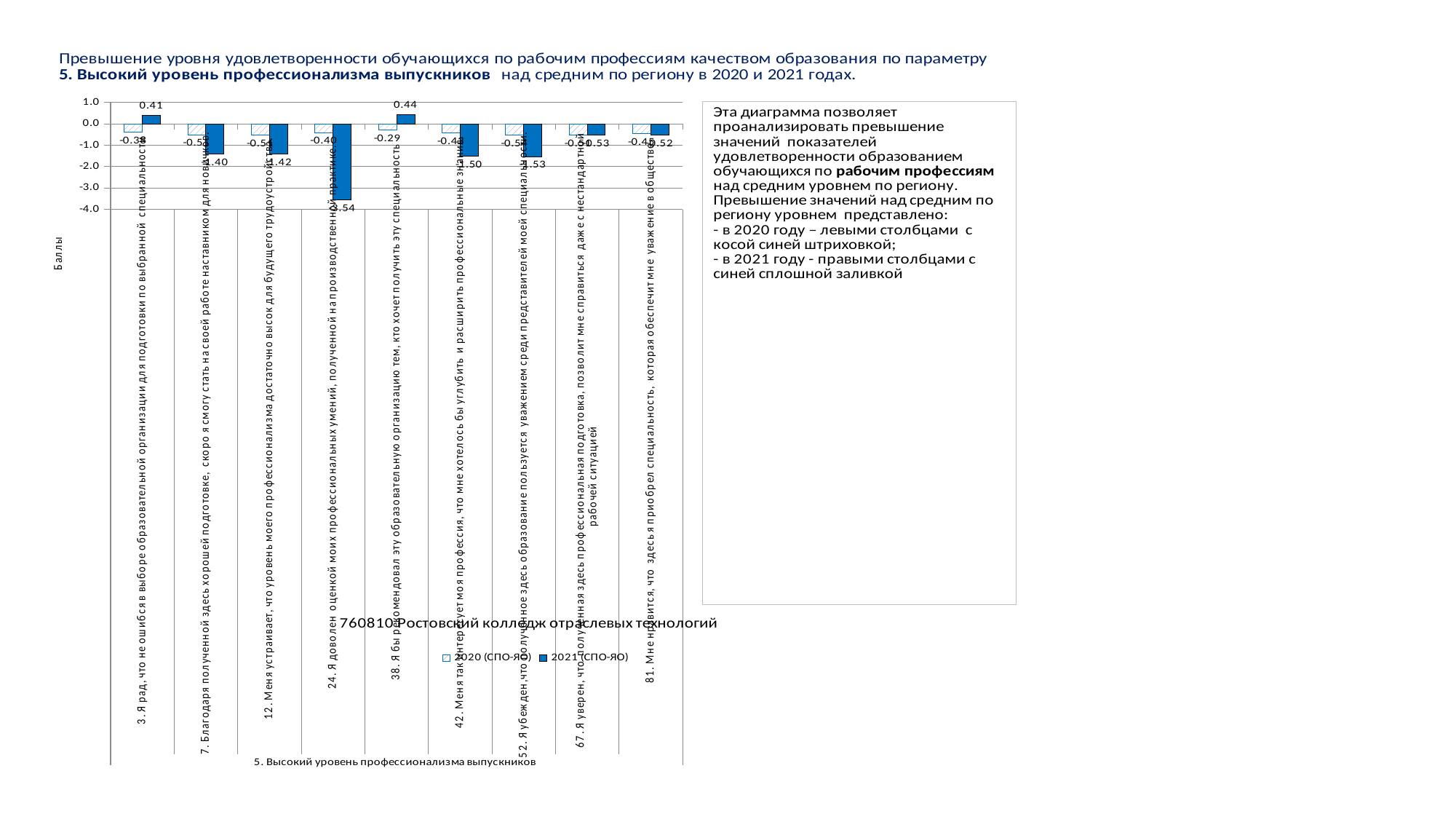
Is the 2021 (СПО-ЯО) value for statement 24 greater or less than -3.0? less How many statements (categories) are plotted on the x axis? 9 What kind of chart is shown on the slide? Bar chart Which statement has the highest 2021 (СПО-ЯО) value? 38. Я бы рекомендовал эту образовательную организацию тем, кто хочет получить эту специальность How many series does the legend list? 2 Which statement has the lowest 2021 (СПО-ЯО) value? 24. Я доволен оценкой моих профессиональных умений, полученной на производственной практике What is the 2021 (СПО-ЯО) value for the statement "3. Я рад, что не ошибся в выборе образовательной организации для подготовки по выбранной специальности"? 0.41 What is the 2020 (СПО-ЯО) value for the statement "81. Мне нравится, что здесь я приобрел специальность, которая обеспечит мне уважение в обществе"? -0.45 What is the 2021 (СПО-ЯО) value for the statement "24. Я доволен оценкой моих профессиональных умений, полученной на производственной практике"? -3.54 What is the difference between the 2021 (СПО-ЯО) values for statement 42 (-1.50) and statement 52 (-1.53)? 0.03 For statement 38, which is larger: the 2020 (СПО-ЯО) value or the 2021 (СПО-ЯО) value? 2021 (СПО-ЯО) What is the 2021 (СПО-ЯО) value for the statement "38. Я бы рекомендовал эту образовательную организацию тем, кто хочет получить эту специальность"? 0.44